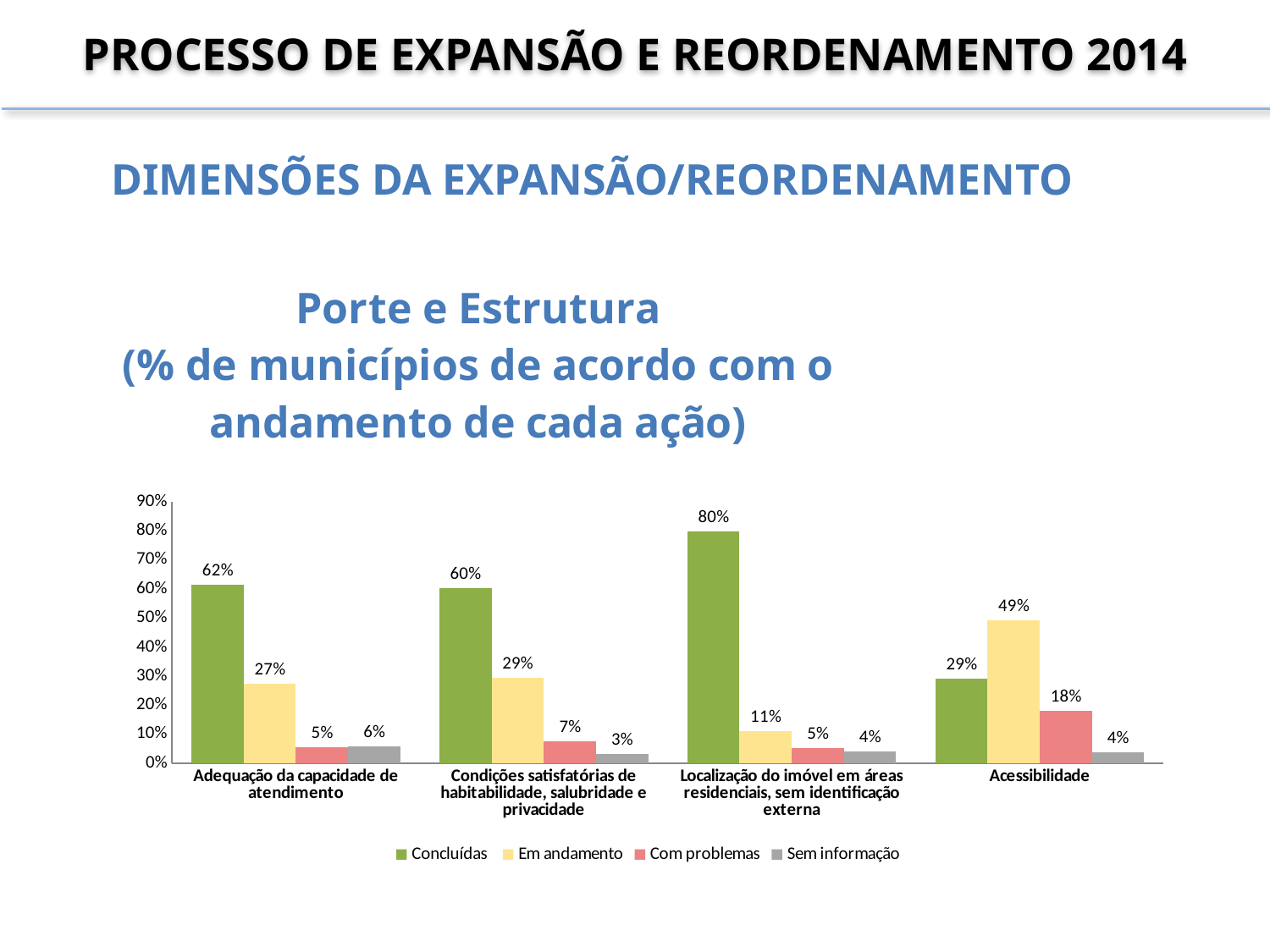
Which category has the highest value for Concluídas? Localização do imóvel em áreas residenciais, sem identificação externa What is the value for Em andamento in the Localização do imóvel em áreas residenciais, sem identificação externa category? 11% Which category has the lowest value for Sem informação? Condições satisfatórias de habitabilidade, salubridade e privacidade Which is larger in the Acessibilidade category: Concluídas or Em andamento? Em andamento Is the value for Concluídas in the Localização do imóvel em áreas residenciais, sem identificação externa category greater or less than 70%? greater What is the difference between the Concluídas and Em andamento values in the Adequação da capacidade de atendimento category? 35% What kind of chart is shown on the slide? bar chart What is the value for Com problemas in the Condições satisfatórias de habitabilidade, salubridade e privacidade category? 7% How many series does the legend list? 4 What is the value for Concluídas in the Acessibilidade category? 29% Which colour represents the Com problemas series? red How many categories are shown on the x axis? 4